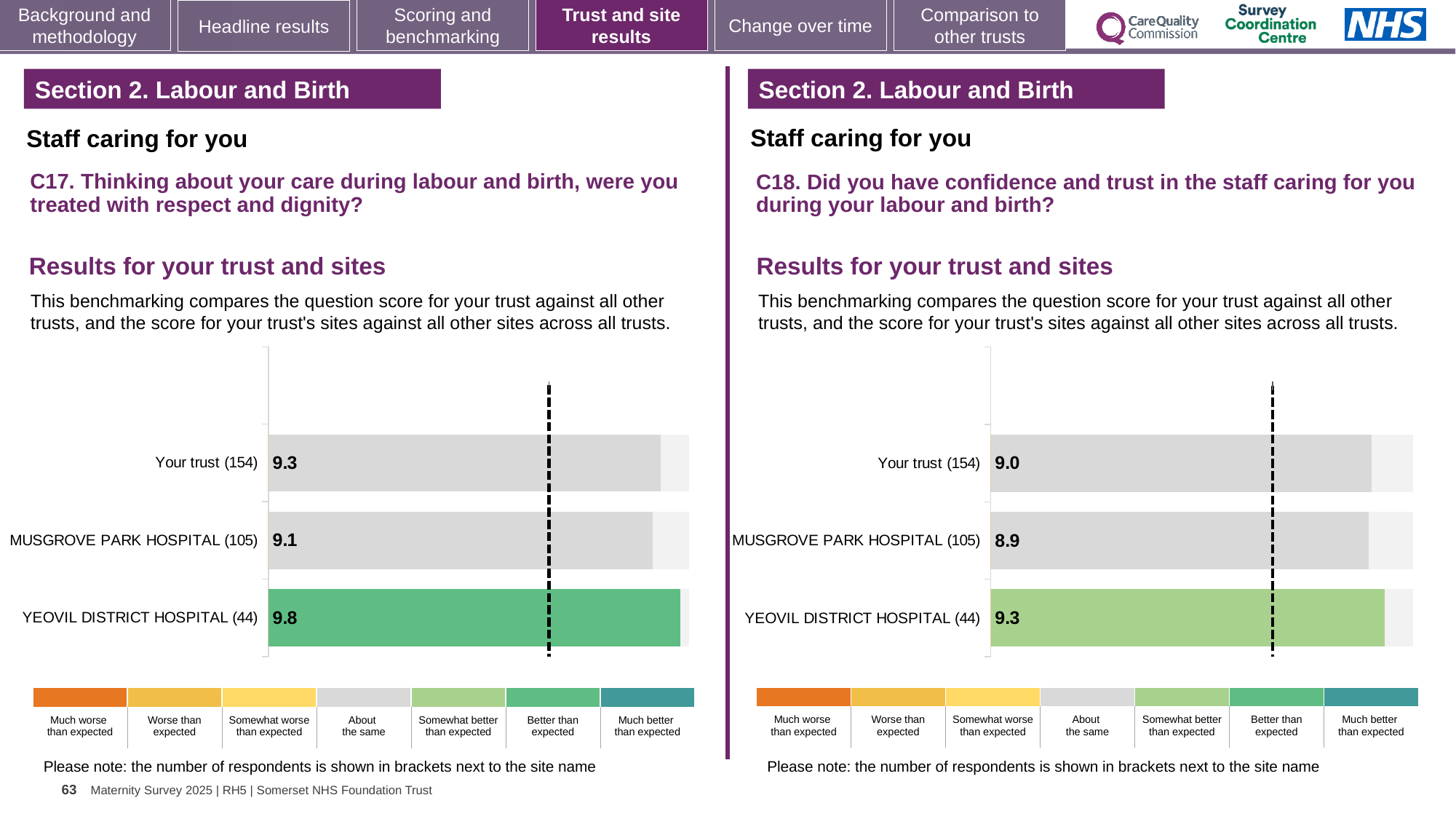
On the C18 chart (right), what is the difference between the scores for Your trust and MUSGROVE PARK HOSPITAL? 0.1 On the C17 chart (left), what is the difference between the scores for YEOVIL DISTRICT HOSPITAL and MUSGROVE PARK HOSPITAL? 0.7 On the C17 chart (left), what is the score for Your trust? 9.3 What kind of chart is the C18 chart (right)? Bar chart On the C18 chart (right), what is the score for YEOVIL DISTRICT HOSPITAL? 9.3 On the C18 chart (right), which has the larger score, Your trust or YEOVIL DISTRICT HOSPITAL? YEOVIL DISTRICT HOSPITAL On the C17 chart (left), how many respondents are shown in brackets for YEOVIL DISTRICT HOSPITAL? 44 On the C18 chart (right), what is the score for Your trust? 9.0 How many bars are plotted on the C17 chart (left)? 3 On the C17 chart (left), which site or trust has the highest score? YEOVIL DISTRICT HOSPITAL On the C18 chart (right), which site or trust has the lowest score? MUSGROVE PARK HOSPITAL On the C17 chart (left), what is the score for MUSGROVE PARK HOSPITAL? 9.1